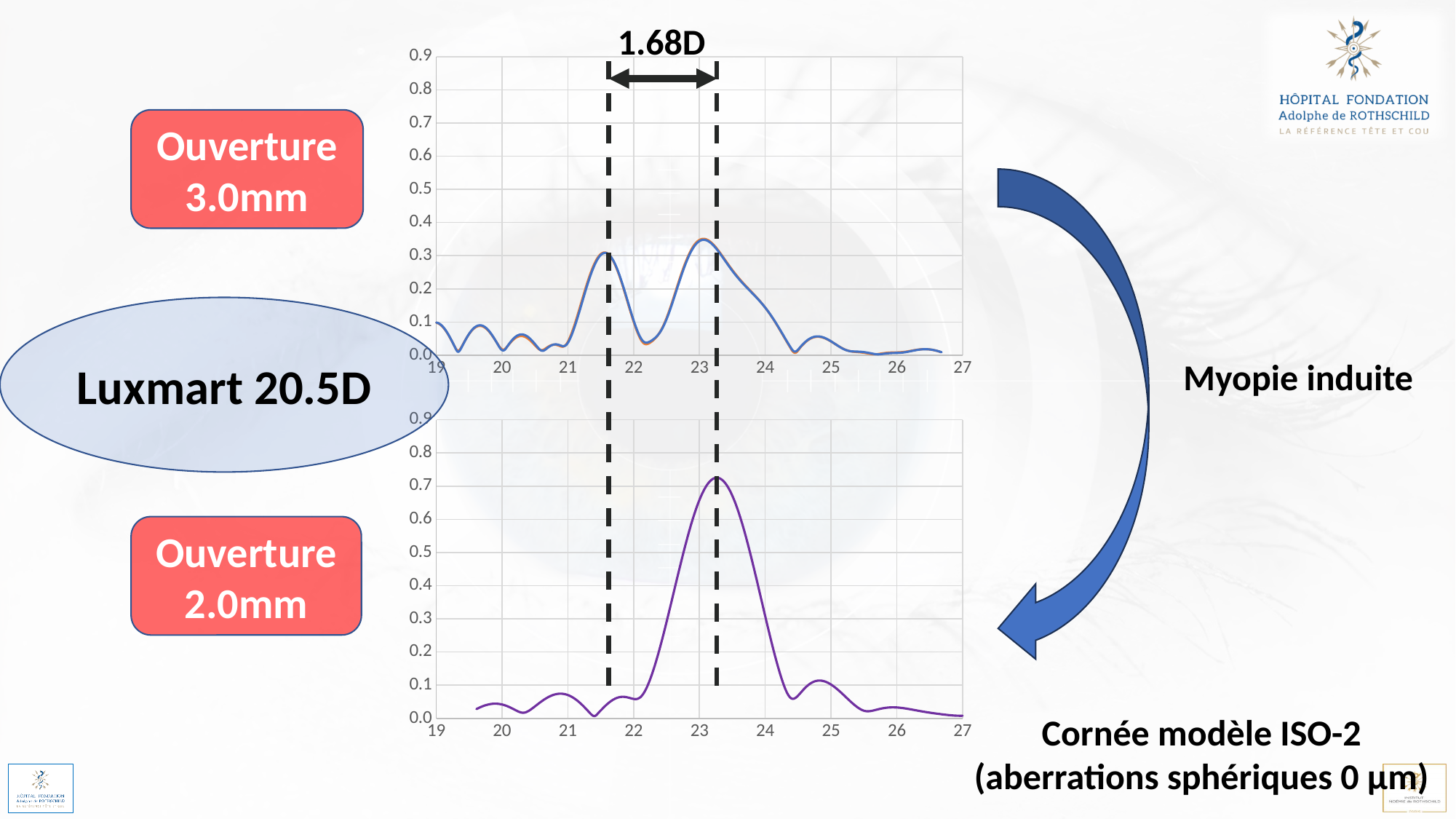
In the bottom chart (Ouverture 2.0mm), does the line rise or fall between x = 22 and x = 23? rise In the top chart (Ouverture 3.0mm), is the peak near x = 21.5 greater or less than 0.2? greater Which chart reaches a higher maximum value, the top chart (Ouverture 3.0mm) or the bottom chart (Ouverture 2.0mm)? the bottom chart (Ouverture 2.0mm) In the bottom chart (Ouverture 2.0mm), is the value of the line at x = 26 greater or less than 0.1? less What is the maximum value shown on the y axis of the top chart (Ouverture 3.0mm)? 0.9 What range does the x axis of the bottom chart (Ouverture 2.0mm) cover? 19 to 27 In the bottom chart (Ouverture 2.0mm), is the highest peak of the line greater or less than 0.6? greater In the top chart (Ouverture 3.0mm), which of the two main peaks is higher, the one near x = 21.5 or the one near x = 23? the one near x = 23 What kind of chart is the top chart (Ouverture 3.0mm)? line chart In the top chart (Ouverture 3.0mm), does the line rise or fall between x = 23 and x = 24? fall What kind of chart is the bottom chart (Ouverture 2.0mm)? line chart